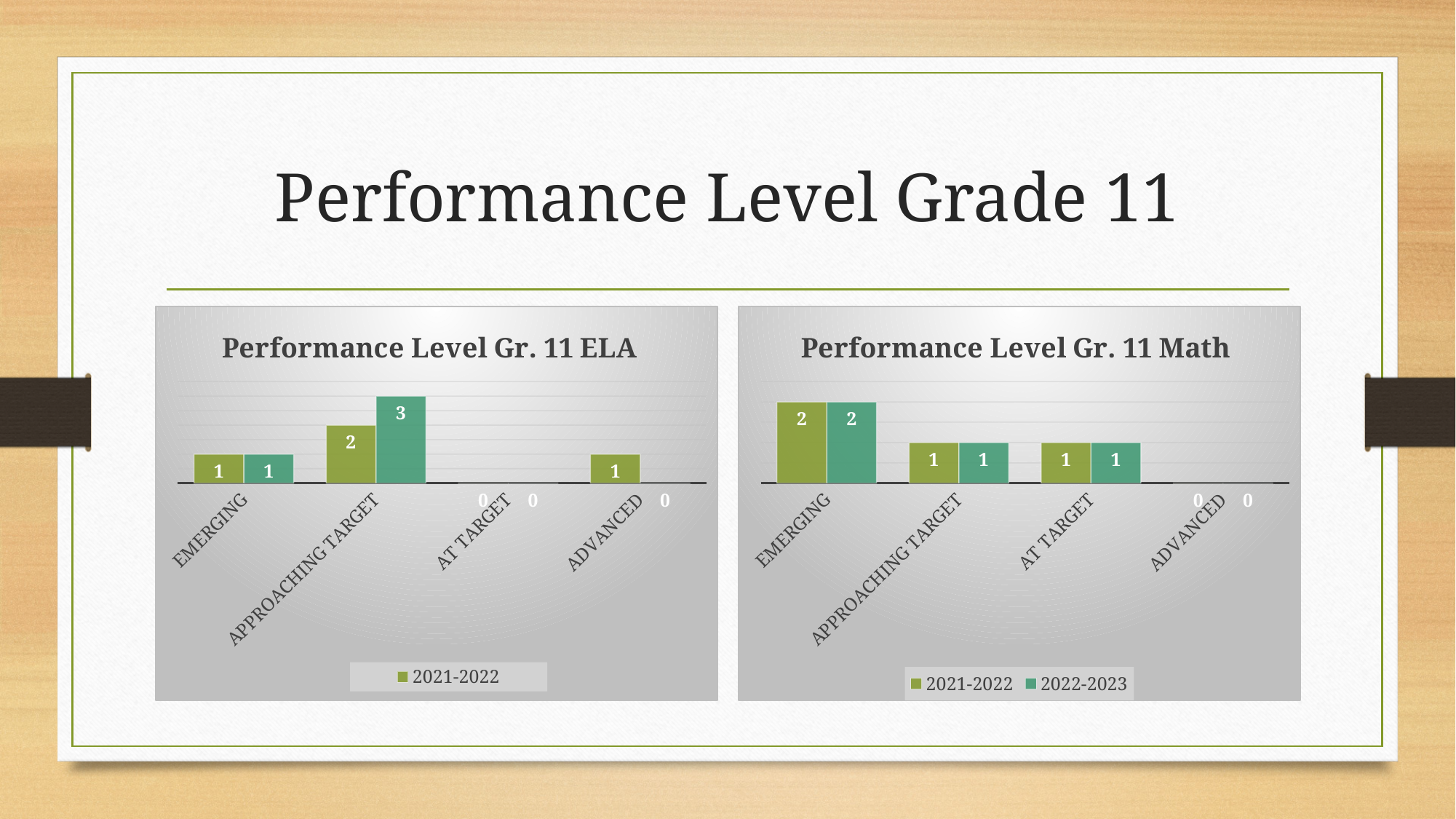
In the Performance Level Gr. 11 ELA chart, what is the difference between the two bars for APPROACHING TARGET? 1 How many categories are shown on the x axis of the Performance Level Gr. 11 Math chart? 4 How many series does the legend of the Performance Level Gr. 11 Math chart list? 2 In the Performance Level Gr. 11 Math chart, which category has the highest values? EMERGING In the Performance Level Gr. 11 ELA chart, what is the value for AT TARGET? 0 In the Performance Level Gr. 11 ELA chart, what is the 2021-2022 value for ADVANCED? 1 In the Performance Level Gr. 11 ELA chart, which category has the highest bar? APPROACHING TARGET In the Performance Level Gr. 11 ELA chart, what is the value of the taller (teal) bar for APPROACHING TARGET? 3 In the Performance Level Gr. 11 Math chart, what is the 2021-2022 value for EMERGING? 2 In the Performance Level Gr. 11 ELA chart, what is the 2021-2022 value for APPROACHING TARGET? 2 In the Performance Level Gr. 11 Math chart, what is the 2022-2023 value for AT TARGET? 1 What kind of chart is the Performance Level Gr. 11 Math chart? Bar chart